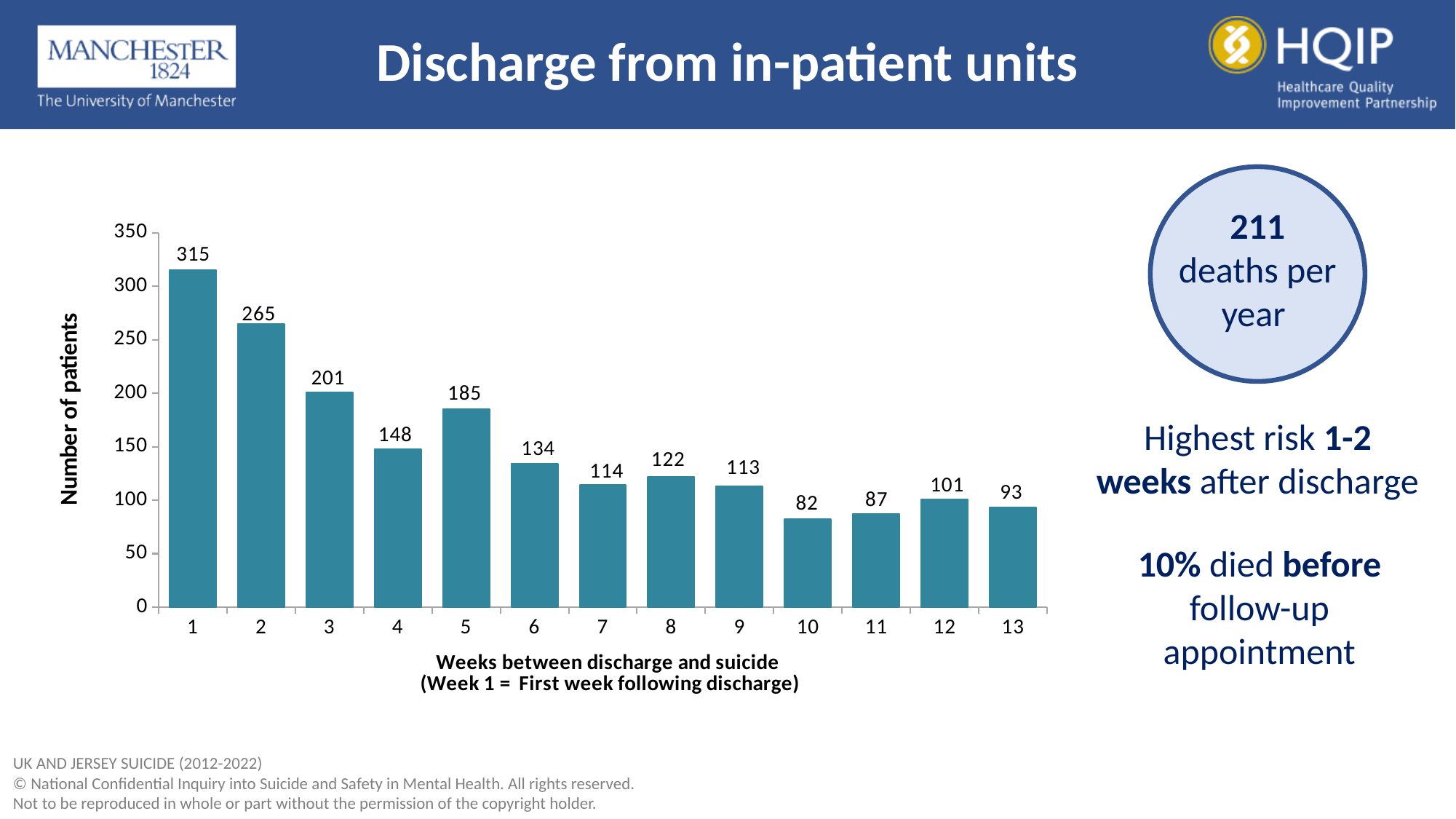
What is the number of patients for week 5? 185 What is the number of patients for week 1? 315 How many weeks are shown on the x axis? 13 What is the number of patients for week 10? 82 What is the difference in number of patients between week 1 and week 2? 50 Which has more patients, week 8 or week 9? Week 8 Which week has the lowest number of patients? 10 What kind of chart is shown on the slide? Bar chart What is the label of the y axis? Number of patients Which week has the highest number of patients? 1 Is the value for week 3 greater or less than 200? greater What is the difference in number of patients between week 4 and week 5? 37